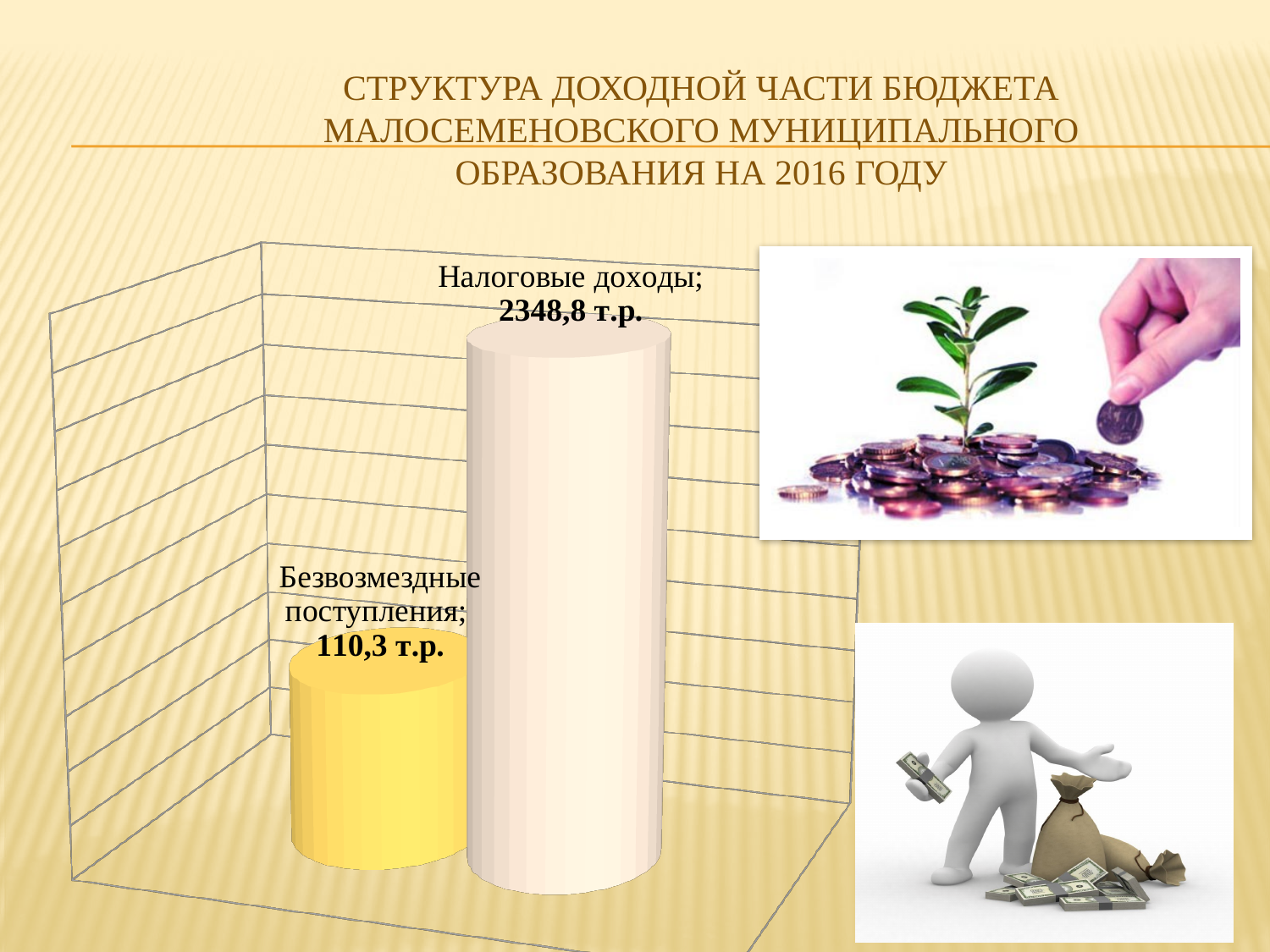
What is the difference between the values for Налоговые доходы and Безвозмездные поступления? 2238,5 т.р. How many categories are plotted in the chart? 2 What kind of chart is shown on the slide? Bar chart Which category has the lowest value? Безвозмездные поступления What colour is the bar for Безвозмездные поступления? Yellow What is the value for Безвозмездные поступления? 110,3 т.р. What is the value for Налоговые доходы? 2348,8 т.р. Which is larger, Налоговые доходы or Безвозмездные поступления? Налоговые доходы Which year does the slide title say the budget revenue structure refers to? 2016 Which category has the highest value? Налоговые доходы